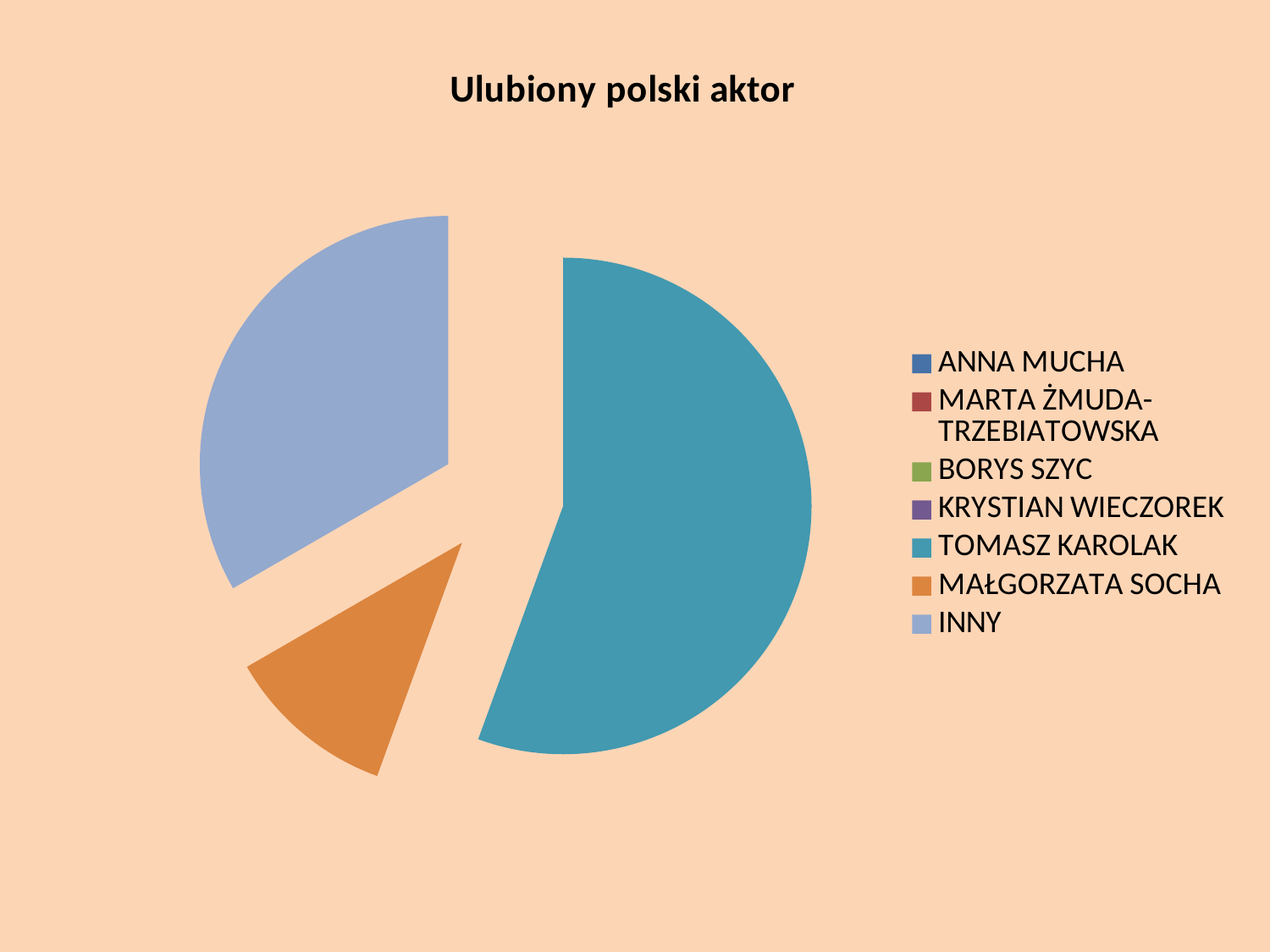
Which slice is larger, INNY or MAŁGORZATA SOCHA? INNY Which slice is larger, TOMASZ KAROLAK or INNY? TOMASZ KAROLAK What kind of chart is shown on the slide? pie chart Which category has the largest slice of the pie? TOMASZ KAROLAK How many slices are visible in the pie chart? 3 Which category is represented by the orange slice? MAŁGORZATA SOCHA Which of the visible slices is the smallest? MAŁGORZATA SOCHA What is the title of the chart? Ulubiony polski aktor How many entries does the chart's legend list? 7